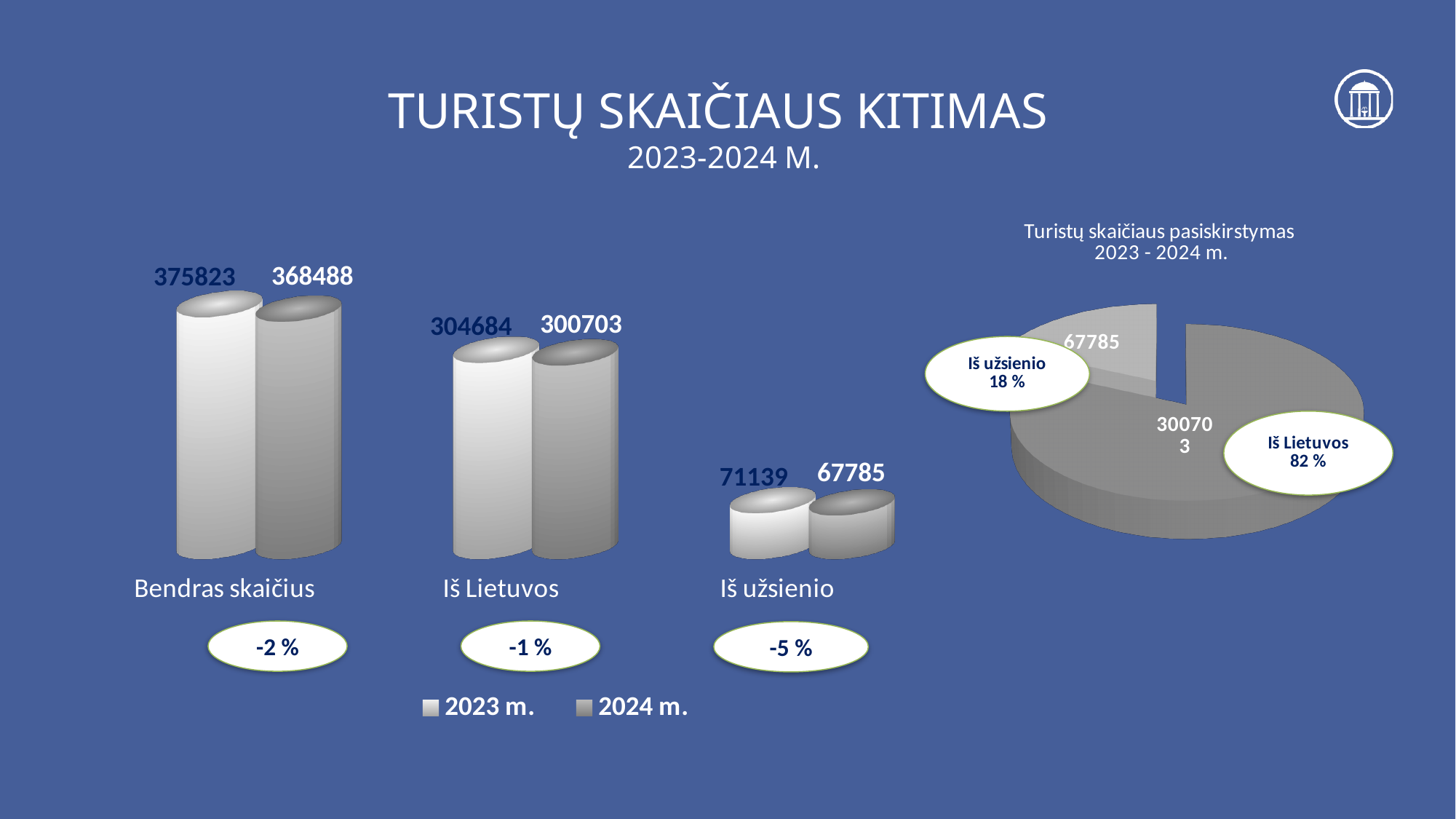
In the bar chart on the left, which is larger for Iš Lietuvos: the 2023 m. value or the 2024 m. value? 2023 m. In the bar chart on the left, what is the value for Iš Lietuvos in 2023 m.? 304684 In the bar chart on the left, which category has the lowest values? Iš užsienio How many categories does the bar chart on the left show? 3 In the pie chart on the right, what share does Iš Lietuvos have? 82 % In the bar chart on the left, what is the difference between the 2023 m. and 2024 m. values for Iš užsienio? 3354 In the bar chart on the left, what is the difference between the 2023 m. and 2024 m. values for Bendras skaičius? 7335 What kind of chart is the chart on the right titled 'Turistų skaičiaus pasiskirstymas 2023 - 2024 m.'? pie chart In the bar chart on the left, what is the value for Bendras skaičius in 2023 m.? 375823 In the bar chart on the left, which category has the highest values? Bendras skaičius In the bar chart on the left, what is the value for Iš užsienio in 2024 m.? 67785 How many series does the legend of the bar chart on the left list? 2